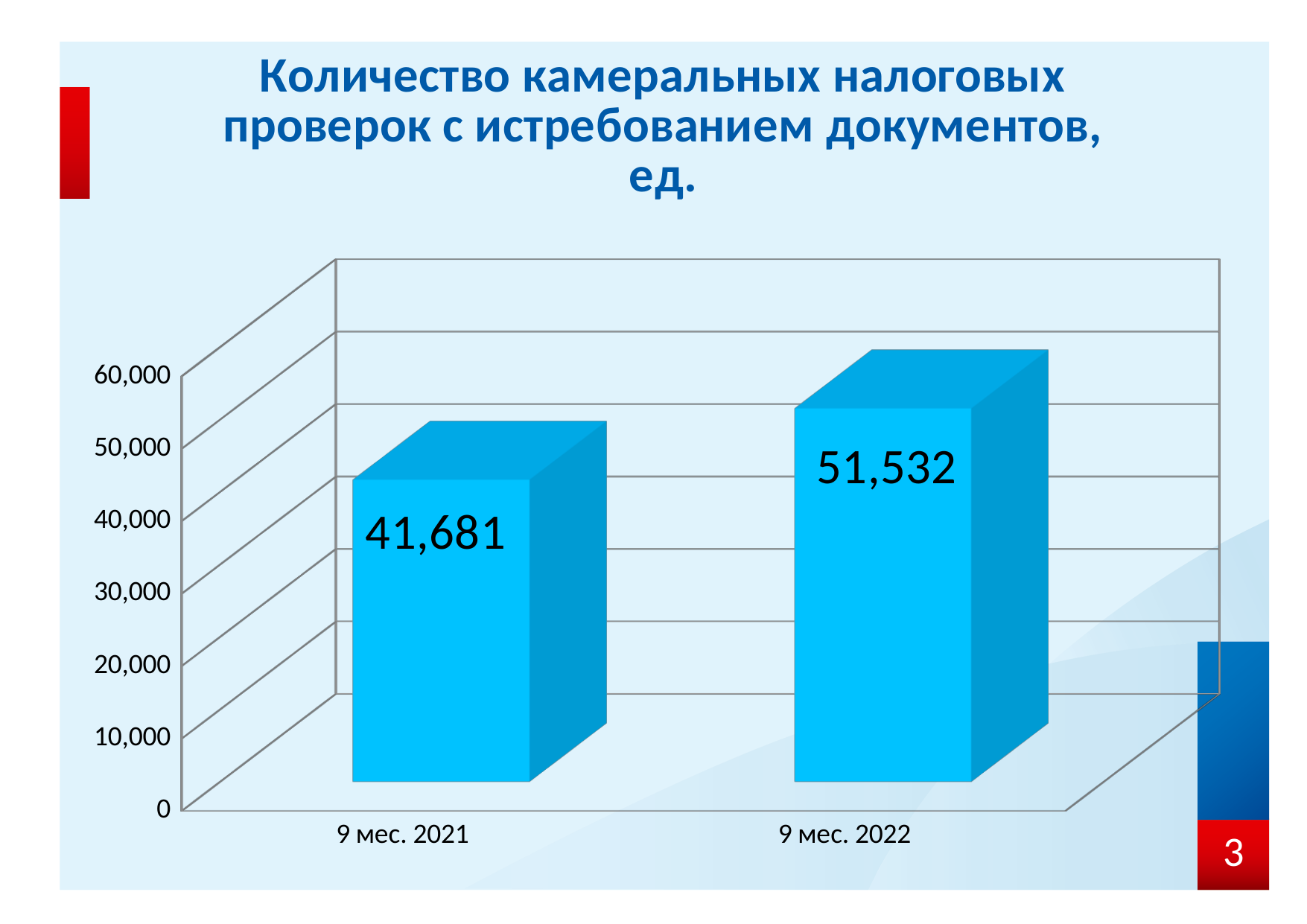
Which category has the lowest value? 9 мес. 2021 What kind of chart is shown on the slide? bar chart Do the values rise or fall from 9 мес. 2021 to 9 мес. 2022? rise What is the difference between the values for 9 мес. 2022 and 9 мес. 2021? 9,851 Which is larger, the value for 9 мес. 2021 or the value for 9 мес. 2022? 9 мес. 2022 Is the value for 9 мес. 2021 greater or less than 50,000? less Which category has the highest value? 9 мес. 2022 What is the value for 9 мес. 2022? 51,532 How many categories are shown on the x axis? 2 What is the title of the chart? Количество камеральных налоговых проверок с истребованием документов, ед. What is the value for 9 мес. 2021? 41,681 Is the value for 9 мес. 2022 greater or less than 50,000? greater